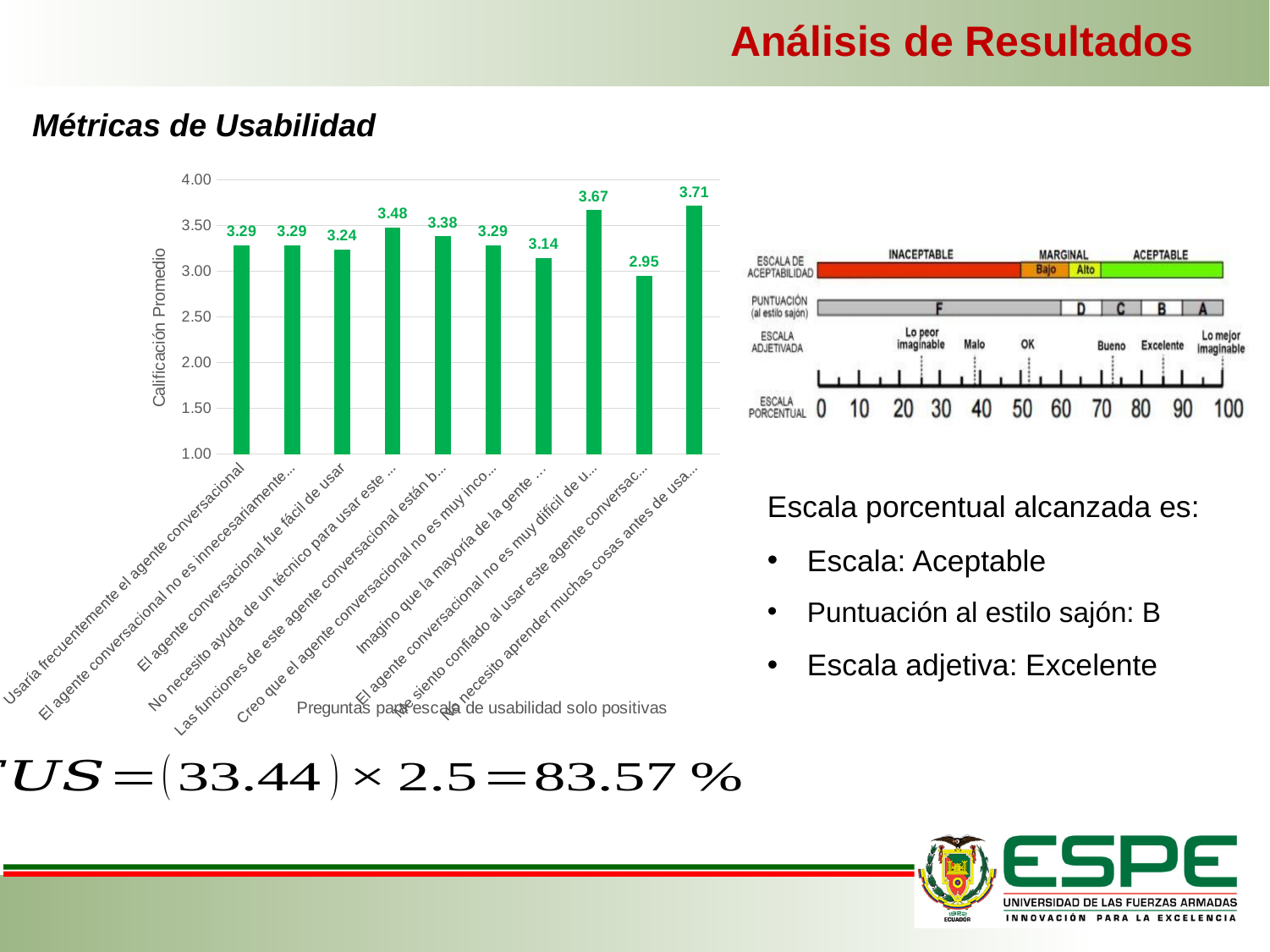
In the bar chart, what is the value for "Usaría frecuentemente el agente conversacional"? 3.29 What is the lowest value shown in the bar chart? 2.95 What kind of chart is used to show the usability metrics? Bar chart What is the difference between the highest and lowest values in the bar chart? 0.76 What is the title of the vertical axis of the bar chart? Calificación Promedio Which has the larger value: "Usaría frecuentemente el agente conversacional" or "El agente conversacional fue fácil de usar"? Usaría frecuentemente el agente conversacional Is the value for "El agente conversacional fue fácil de usar" greater or less than 3.00? greater What is the highest value shown in the bar chart? 3.71 In the bar chart, what is the value for "El agente conversacional fue fácil de usar"? 3.24 What is the difference between the values for "Usaría frecuentemente el agente conversacional" and "El agente conversacional fue fácil de usar"? 0.05 How many bars in the bar chart have a value above 3.50? 2 How many bars are plotted in the bar chart? 10